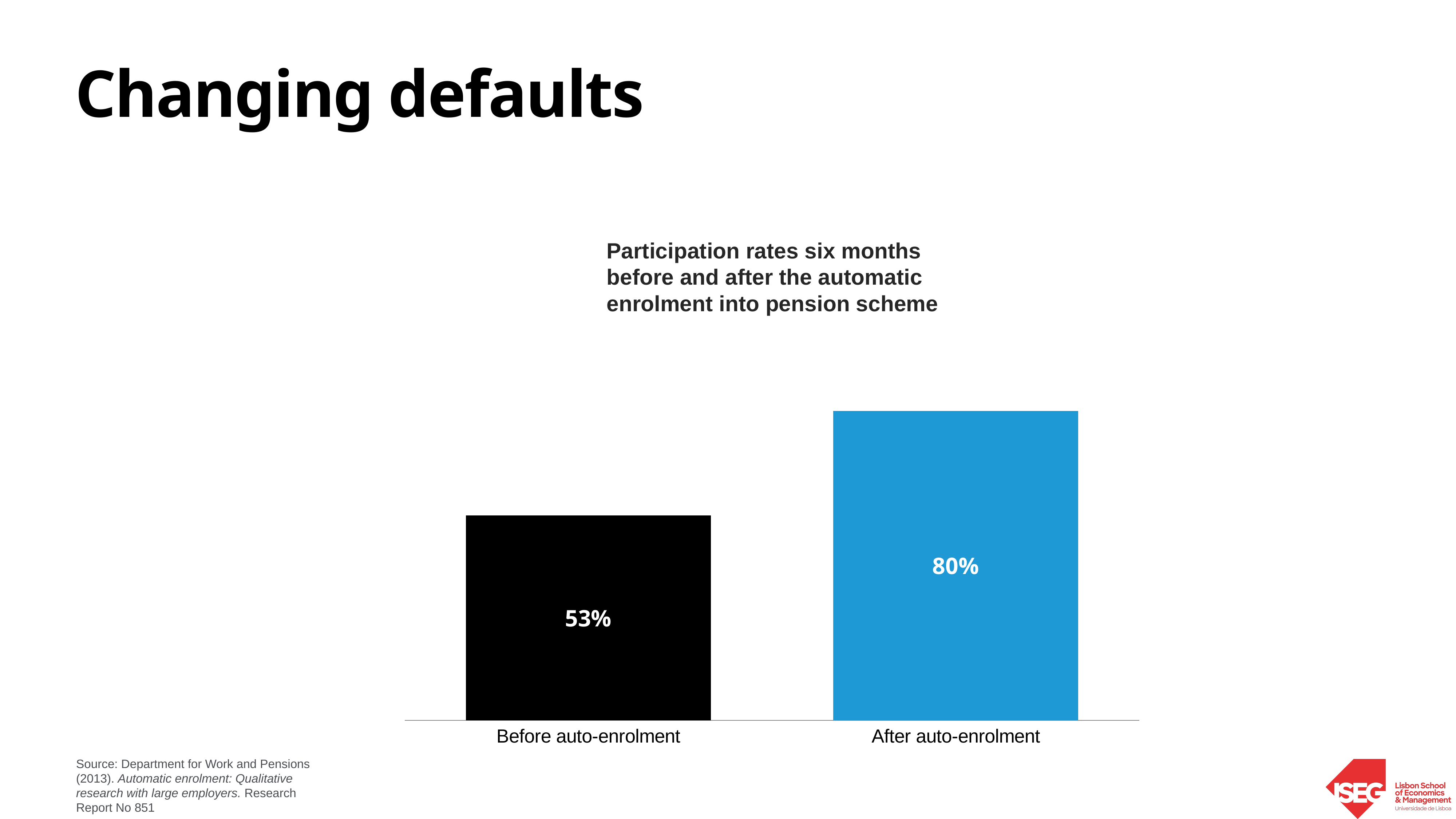
What colour is the bar for After auto-enrolment? blue By how many percentage points does the participation rate after auto-enrolment exceed the rate before auto-enrolment? 27 percentage points How many categories are shown in the chart? 2 What is the participation rate after auto-enrolment? 80% Which category has the lower participation rate? Before auto-enrolment What kind of chart is shown on the slide? bar chart What is the participation rate before auto-enrolment? 53% Which category has the higher participation rate? After auto-enrolment What is the title of the chart? Participation rates six months before and after the automatic enrolment into pension scheme Do the values rise or fall from the left bar to the right bar? rise Is the participation rate before auto-enrolment larger or smaller than the rate after auto-enrolment? smaller